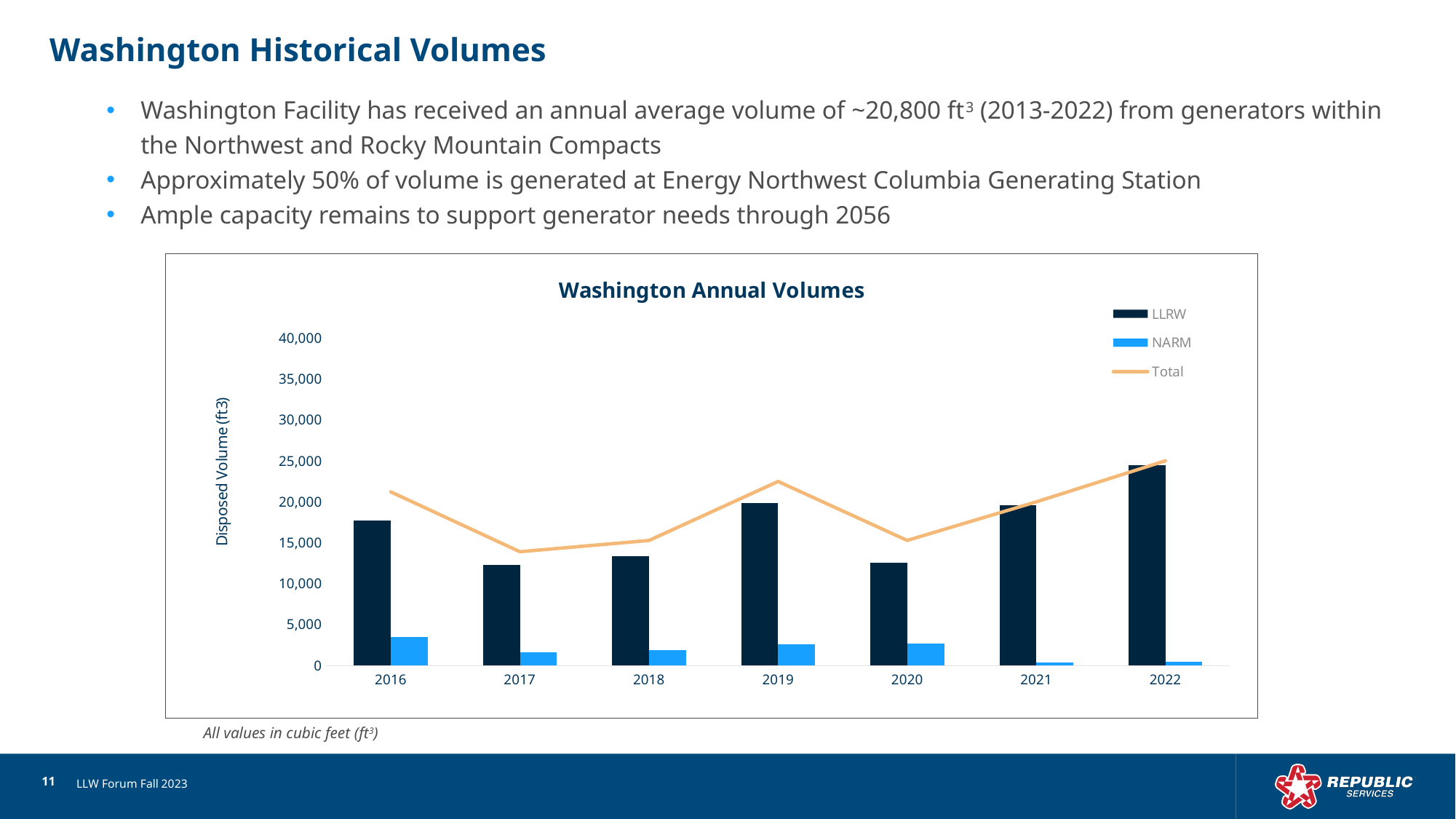
How many years are shown on the x axis of the Washington Annual Volumes chart? 7 Which year has the highest NARM volume? 2016 Which is larger, the LLRW value for 2019 or for 2018? 2019 Is the LLRW value for 2022 greater or less than 20,000? greater How many series does the legend of the Washington Annual Volumes chart list? 3 Is the NARM value for 2016 greater or less than 5,000? less What type of chart is shown on the slide? Bar chart with a line series Is the LLRW value for 2017 greater or less than 15,000? less Does the Total line rise or fall from 2020 to 2022? rise Which year has the highest LLRW volume? 2022 What is the title of the chart on the slide? Washington Annual Volumes